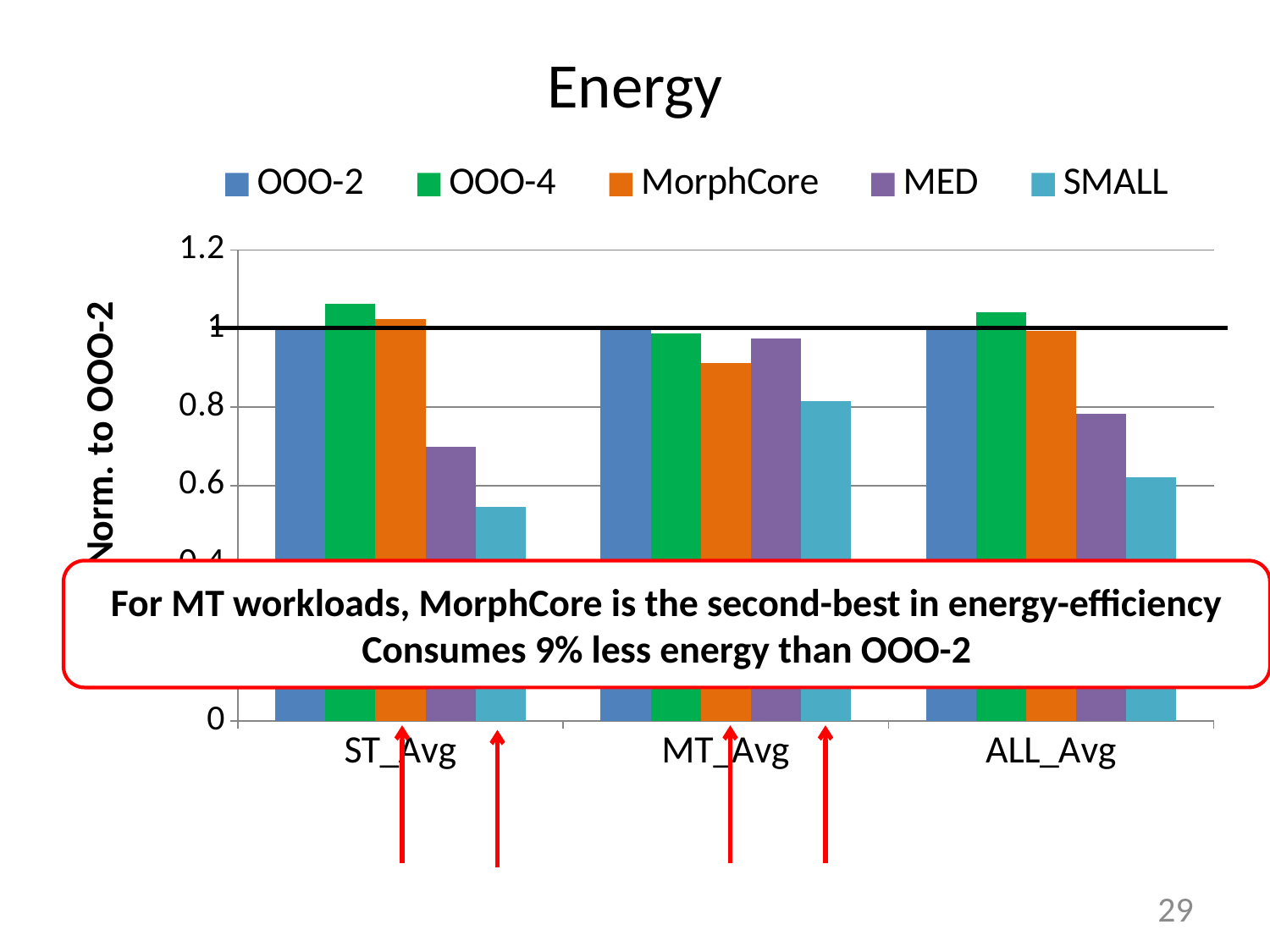
What type of chart is shown on the slide? bar chart Which series has the lowest value in the MT_Avg category? SMALL How many series does the legend list? 5 Which series has the lowest value in the ST_Avg category? SMALL What is the title of the chart? Energy What is the value for OOO-2 in the MT_Avg category? 1 Which series has the highest value in the ST_Avg category? OOO-4 In the MT_Avg category, which is larger: MorphCore or MED? MED Is the value for SMALL in the ST_Avg category greater or less than 0.6? less How many categories are shown on the x axis? 3 Is the value for MorphCore in the MT_Avg category greater or less than 0.8? greater What is the label of the y axis? Norm. to OOO-2